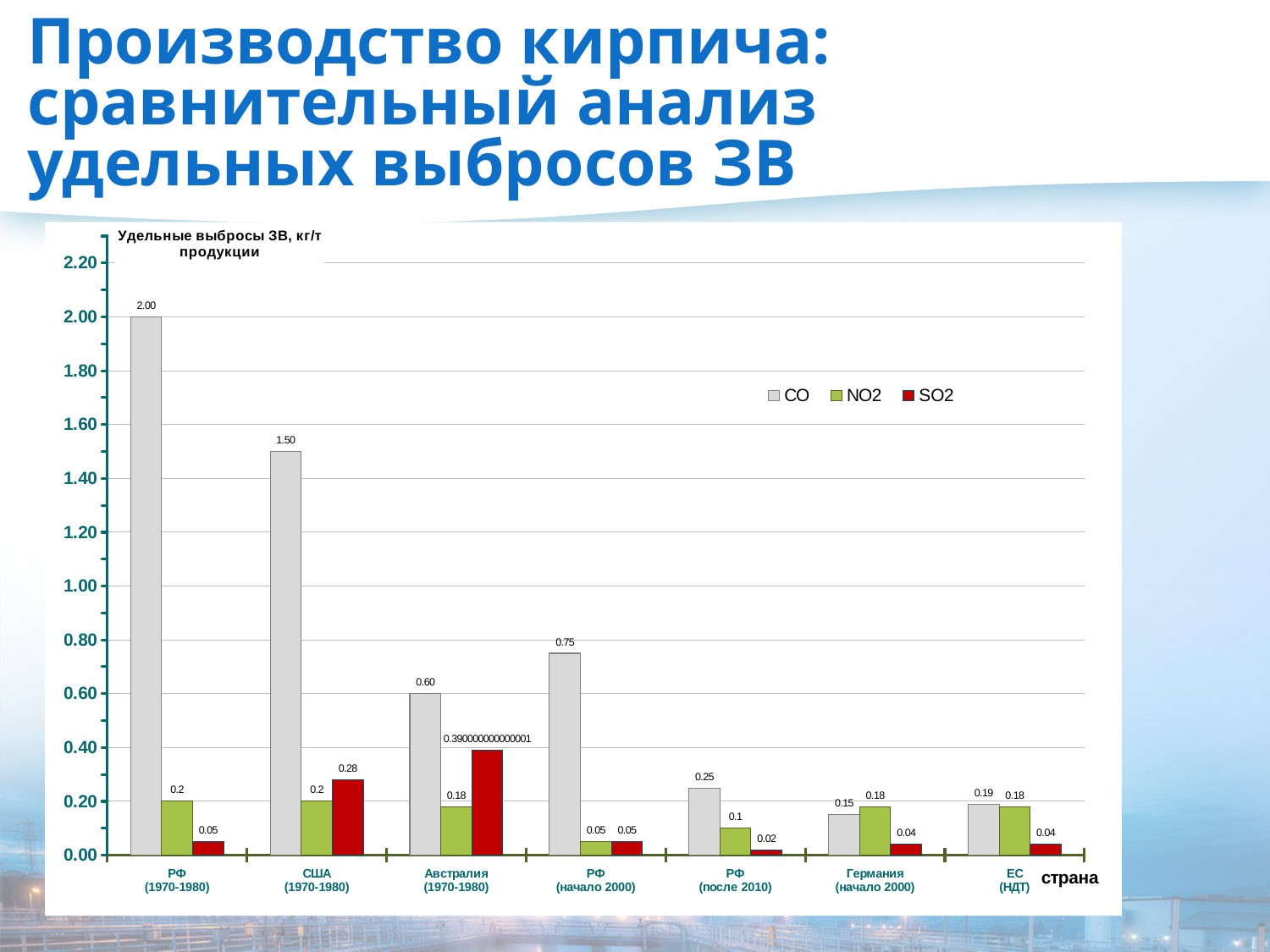
How many series does the legend list? 3 Which category has the lowest SO2 value? РФ (после 2010) How many country/period categories are shown on the x axis? 7 Which is larger: the CO value for Германия (начало 2000) or the CO value for ЕС (НДТ)? ЕС (НДТ) What is the CO value for РФ (1970-1980)? 2.00 What type of chart is shown on the slide? bar chart Is the CO value for Австралия (1970-1980) greater or less than 0.40? greater What is the NO2 value for РФ (после 2010)? 0.1 What is the difference between the CO values for РФ (1970-1980) and США (1970-1980)? 0.50 Which category has the highest CO value? РФ (1970-1980) What is the SO2 value for США (1970-1980)? 0.28 What is the y-axis title of the chart? Удельные выбросы ЗВ, кг/т продукции